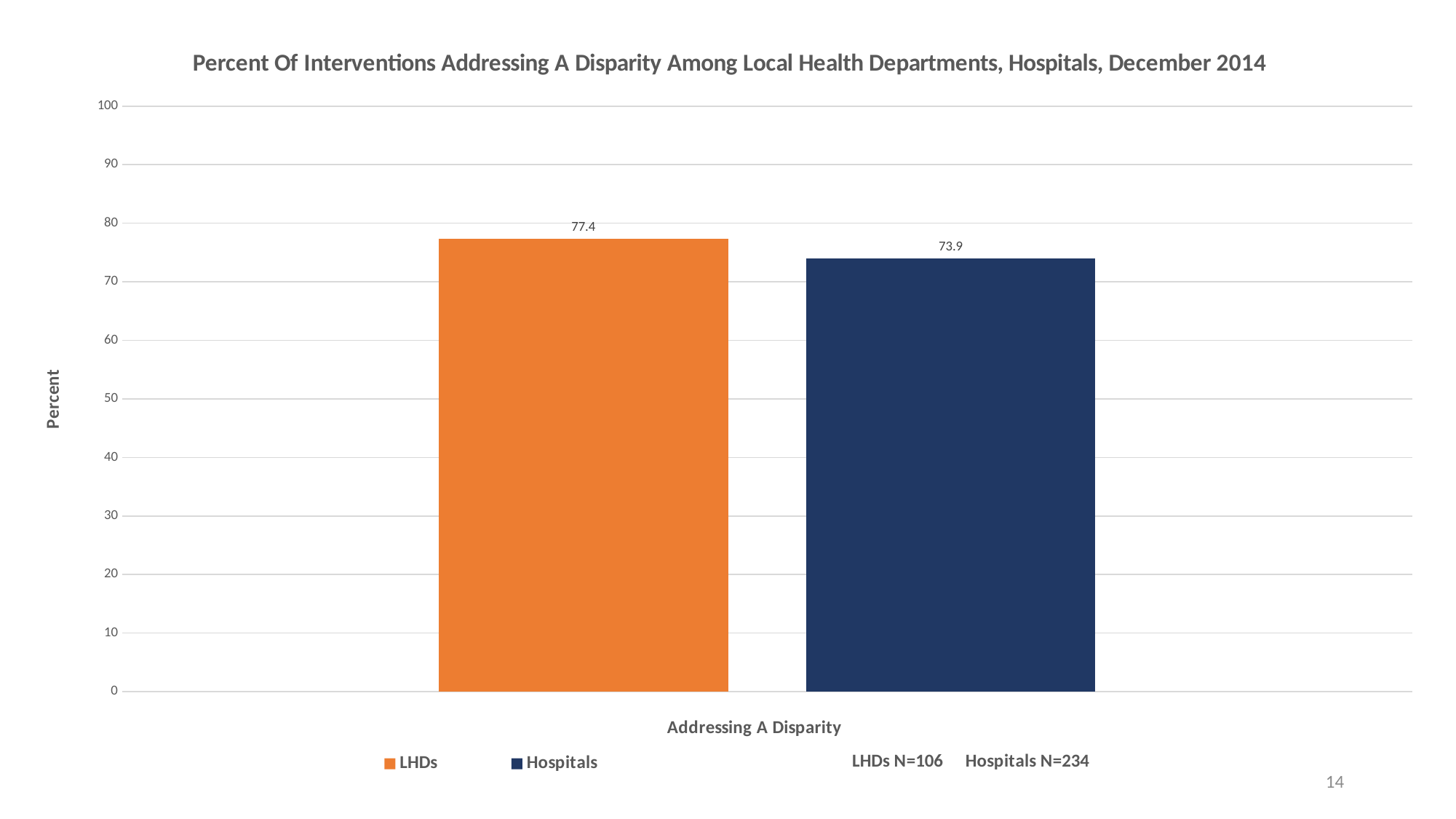
Is the value for LHDs greater or less than 70? greater What kind of chart is shown? Bar chart What is the value for Hospitals? 73.9 Which series has the lowest value? Hospitals What is the value for LHDs? 77.4 How many series does the legend list? 2 What is the category label on the x axis? Addressing A Disparity What is the label on the y axis? Percent Is the value for Hospitals greater or less than 80? less Which series has the higher value, LHDs or Hospitals? LHDs What is the difference between the LHDs value and the Hospitals value? 3.5 What colour is the bar for Hospitals? Dark blue